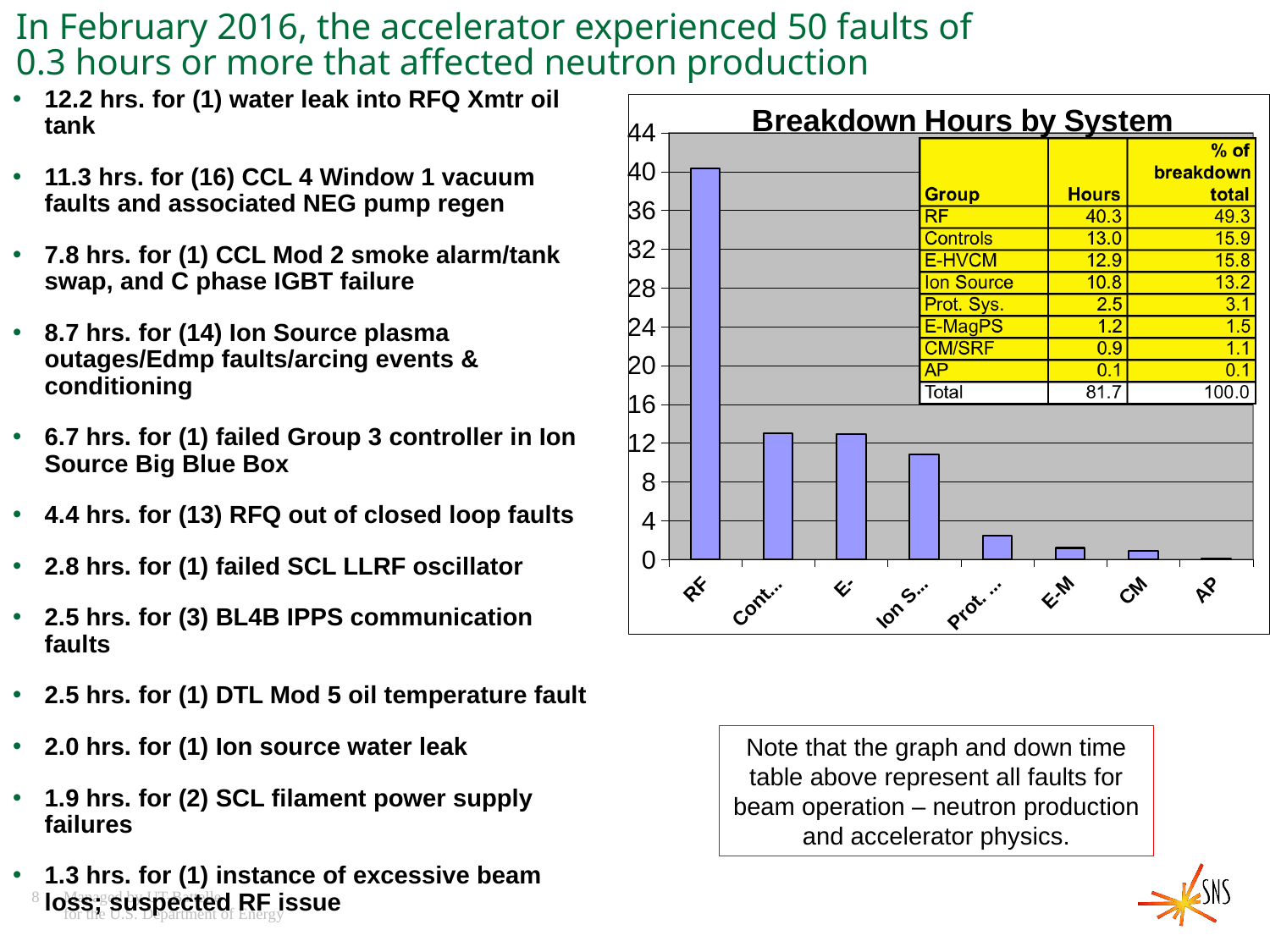
What percentage of the breakdown total does Controls account for? 15.9 How many breakdown hours are attributed to RF in the Breakdown Hours by System chart? 40.3 Which system has the lowest number of breakdown hours? AP What is the total number of breakdown hours listed in the table? 81.7 Do the bar values rise or fall moving from left to right along the x axis? fall Which system has the highest number of breakdown hours? RF How many breakdown hours are attributed to Ion Source? 10.8 What is the difference in breakdown hours between RF and Ion Source? 29.5 Is the value for RF greater or less than 36 on the chart's axis? greater What type of chart is shown under the title "Breakdown Hours by System"? bar chart How many systems (bars) are shown in the Breakdown Hours by System chart? 8 Which has more breakdown hours, Prot. Sys. or E-MagPS? Prot. Sys.